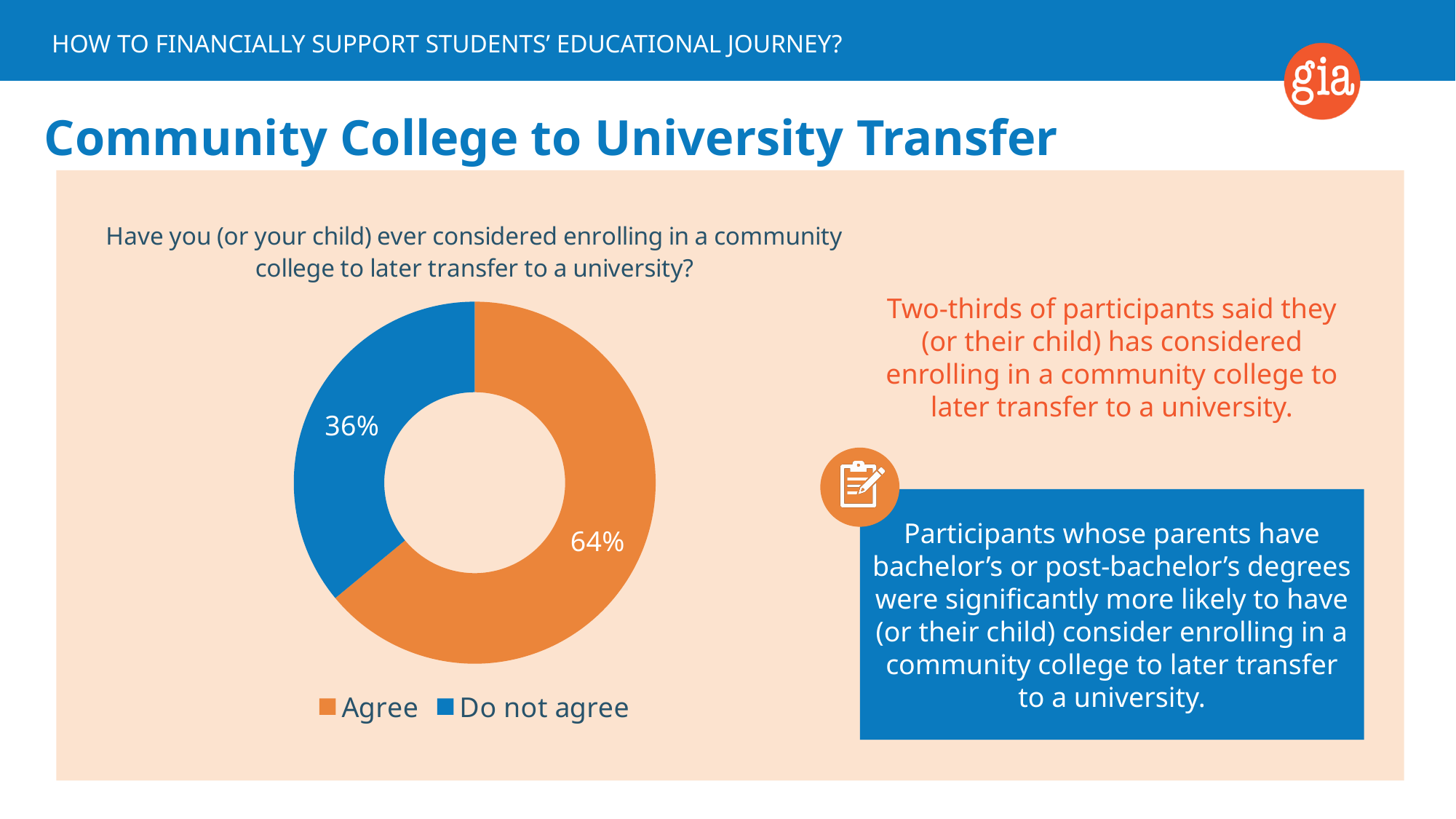
How many categories does the chart show? 2 Which response has the smaller share of the chart? Do not agree Is the share for "Agree" larger or smaller than the share for "Do not agree"? larger What share of the chart does the "Do not agree" slice represent? 36% How many entries does the legend list? 2 Which response has the larger share of the chart? Agree What percentage of participants answered "Agree"? 64% What colour represents "Agree" in the chart? Orange What kind of chart is shown on the slide? Doughnut (pie) chart What percentage of participants answered "Do not agree"? 36% What is the difference in percentage points between "Agree" and "Do not agree"? 28 What question is the chart titled with? Have you (or your child) ever considered enrolling in a community college to later transfer to a university?